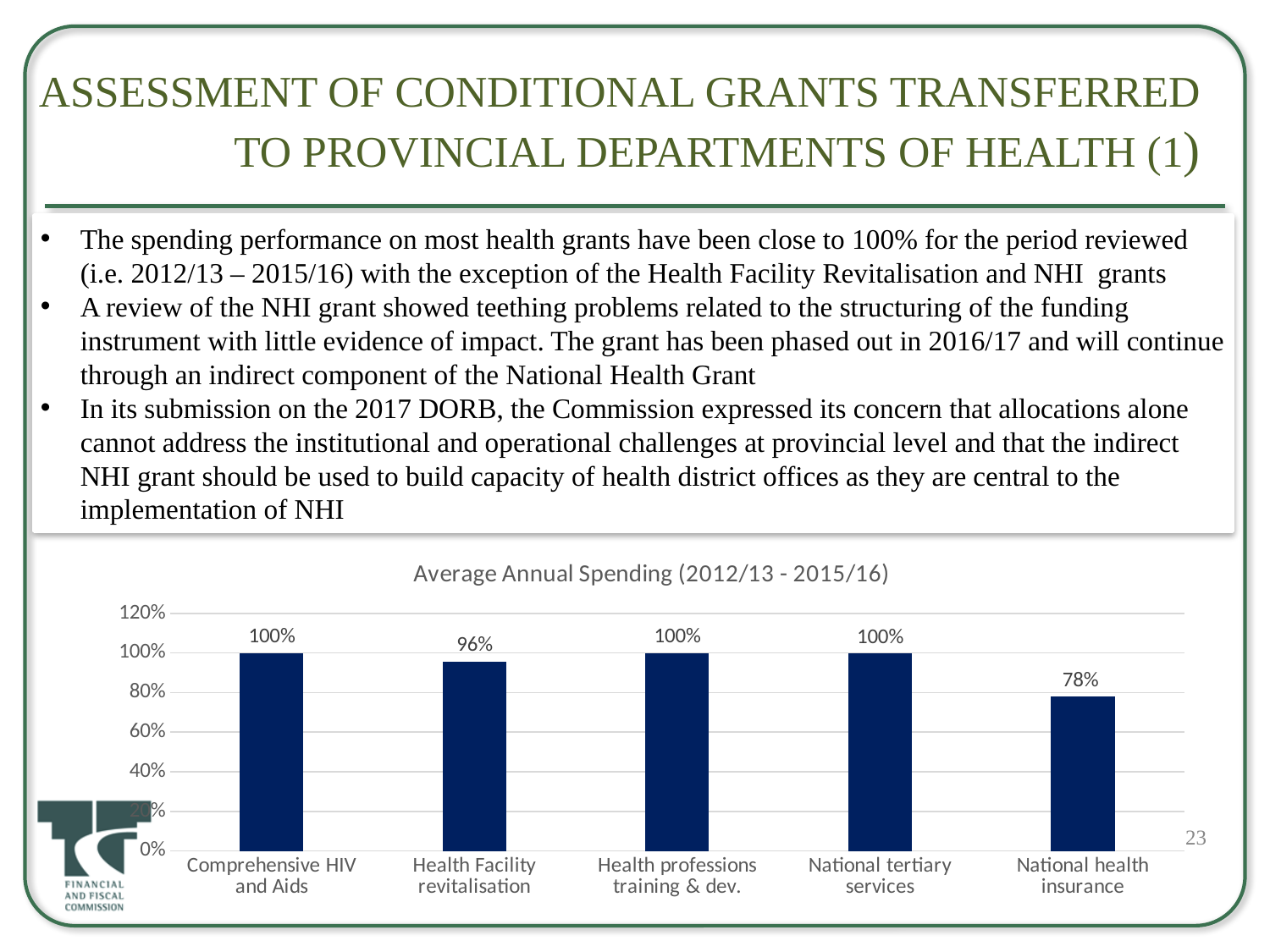
What is the average annual spending value for Health Facility revitalisation? 96% Which is larger, the value for Health professions training & dev. or the value for National health insurance? Health professions training & dev. What is the title of the chart? Average Annual Spending (2012/13 - 2015/16) What kind of chart is shown on the slide? Bar chart What is the average annual spending value for National health insurance? 78% What is the difference between the values for National tertiary services and Health Facility revitalisation? 4% What is the difference between the values for Health Facility revitalisation and National health insurance? 18% How many categories are shown in the chart? 5 Which category has the lowest average annual spending? National health insurance How many categories have a value of 100%? 3 Is the value for National health insurance greater or less than 80%? less What is the average annual spending value for Comprehensive HIV and Aids? 100%